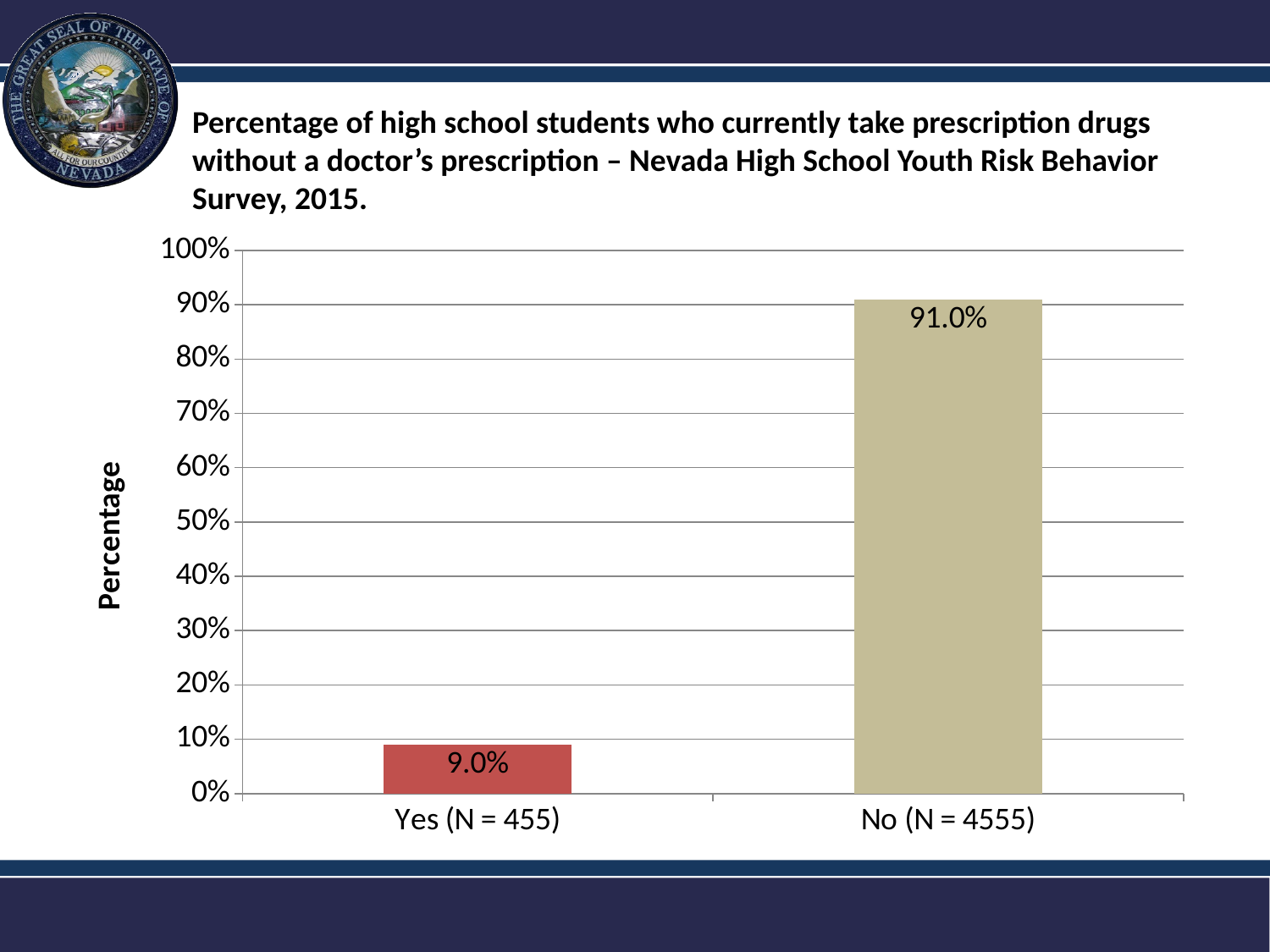
Is the value for Yes (N = 455) greater or less than 10%? less Which category has the highest value? No (N = 4555) Which is larger, the value for Yes (N = 455) or the value for No (N = 4555)? No (N = 4555) Which category has the lowest value? Yes (N = 455) How many categories are shown on the x axis? 2 Is the value for No (N = 4555) greater or less than 90%? greater What kind of chart is shown on the slide? bar chart What is the label of the y axis? Percentage What is the value for No (N = 4555)? 91.0% What is the difference between the values for No (N = 4555) and Yes (N = 455)? 82.0% What is the highest value shown on the y axis? 100% What is the value for Yes (N = 455)? 9.0%